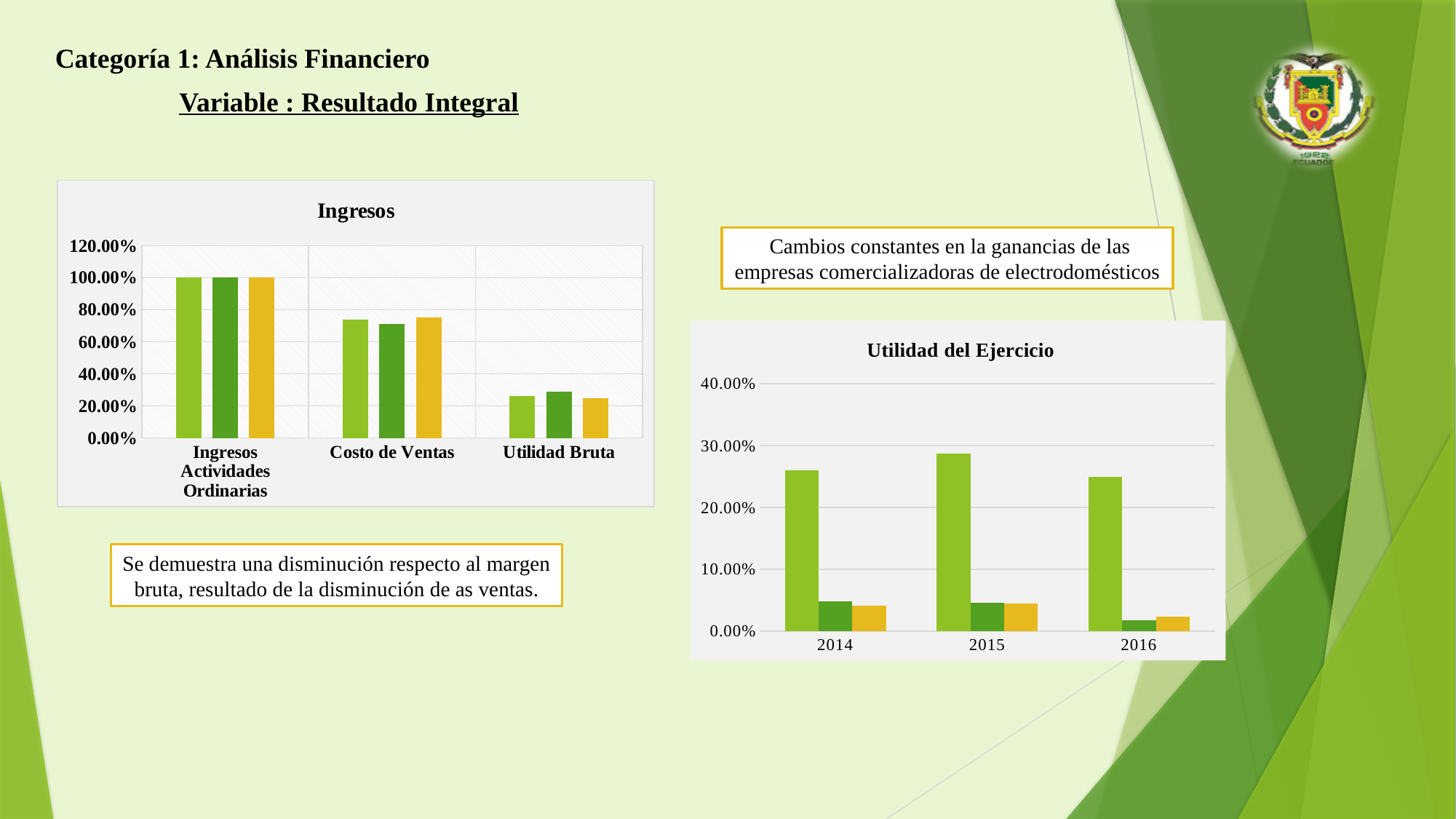
What kind of chart is the "Ingresos" chart on the left? bar chart In the "Utilidad del Ejercicio" chart, is the tallest bar for 2015 greater or less than 20.00%? greater In the "Ingresos" chart, what value do the bars for Ingresos Actividades Ordinarias reach? 100.00% What is the highest value shown on the y axis of the "Ingresos" chart? 120.00% In the "Ingresos" chart, which category has the highest bars? Ingresos Actividades Ordinarias In the "Ingresos" chart, are the bars for Utilidad Bruta greater or less than 40.00%? less What kind of chart is the "Utilidad del Ejercicio" chart on the right? bar chart In the "Ingresos" chart, are the bars for Costo de Ventas greater or less than 60.00%? greater In the "Ingresos" chart, which category has the lowest bars? Utilidad Bruta In the "Ingresos" chart, how many categories are shown on the x axis? 3 In the "Utilidad del Ejercicio" chart, how many years are shown on the x axis? 3 In the "Utilidad del Ejercicio" chart, which year has the taller light green bar, 2015 or 2016? 2015